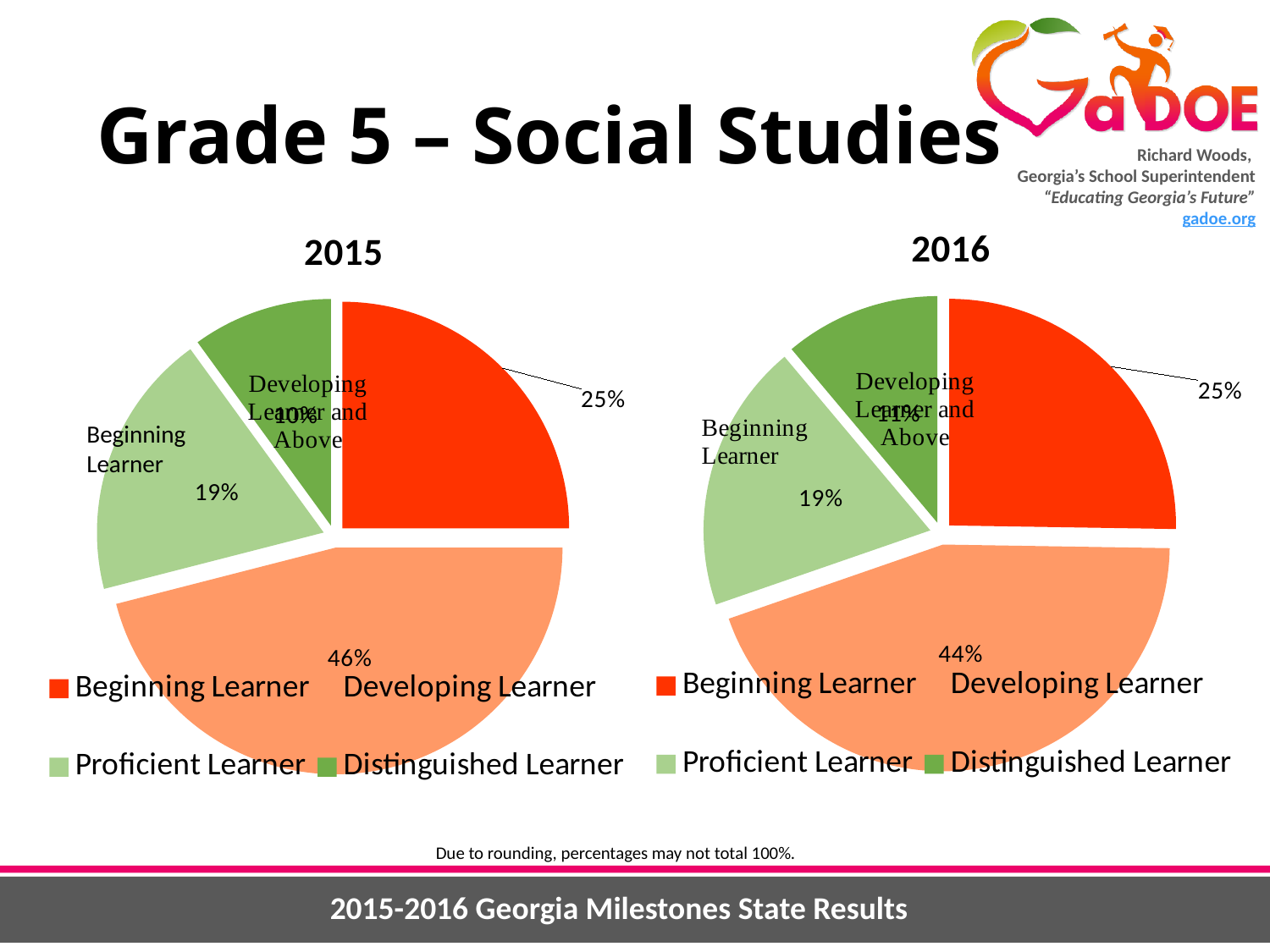
What type of chart is the 2015 chart? Pie chart How many categories does the legend of the 2016 chart list? 4 In the 2016 chart, which colour represents Beginning Learner? Red In the 2016 chart, what percentage is shown for Developing Learner? 44% In the 2015 chart, what percentage is shown for Beginning Learner? 25% In the 2015 chart, which category has the largest slice? Developing Learner What is the difference between the Developing Learner percentage in the 2015 chart and in the 2016 chart? 2% In the 2015 chart, which category has the smallest slice? Distinguished Learner In the 2015 chart, what percentage is shown for Developing Learner? 46% In the 2016 chart, what percentage is shown for Proficient Learner? 19% Is the Distinguished Learner slice larger in the 2015 chart or the 2016 chart? 2016 In the 2016 chart, what percentage is shown for Distinguished Learner? 11%